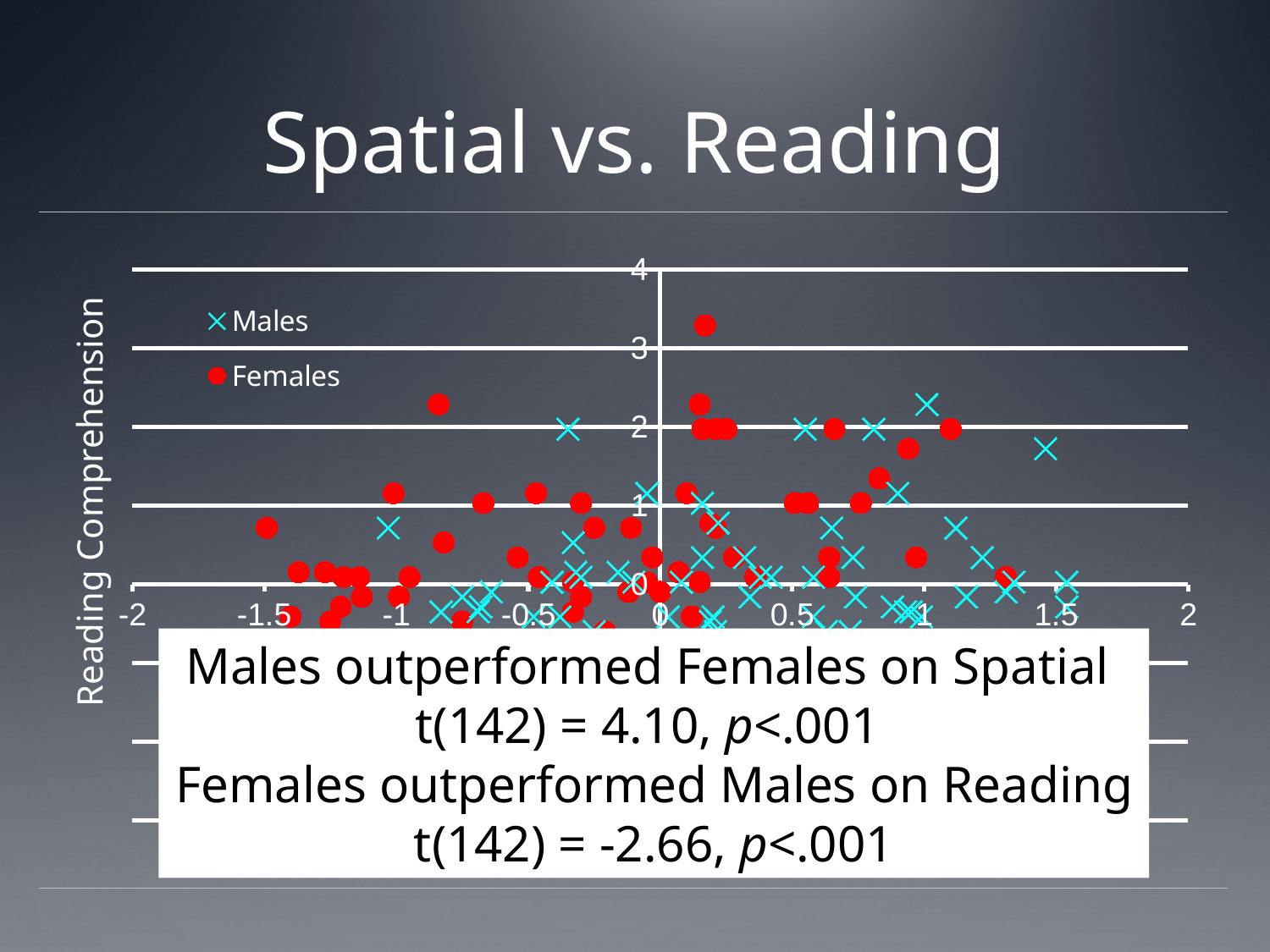
Is the highest Reading Comprehension value plotted greater or less than 3? greater What is the highest value shown on the vertical axis? 4 Which series contains the point farthest to the right on the x axis? Males Which series has the point with the highest Reading Comprehension value? Females What are the two series named in the chart's legend? Males and Females What is the title of the chart? Spatial vs. Reading Which series contains the point farthest to the left on the x axis? Females Is the rightmost Males point's Reading Comprehension value greater or less than 1? less How many series does the chart's legend list? 2 What kind of chart is shown on the slide? Scatter chart